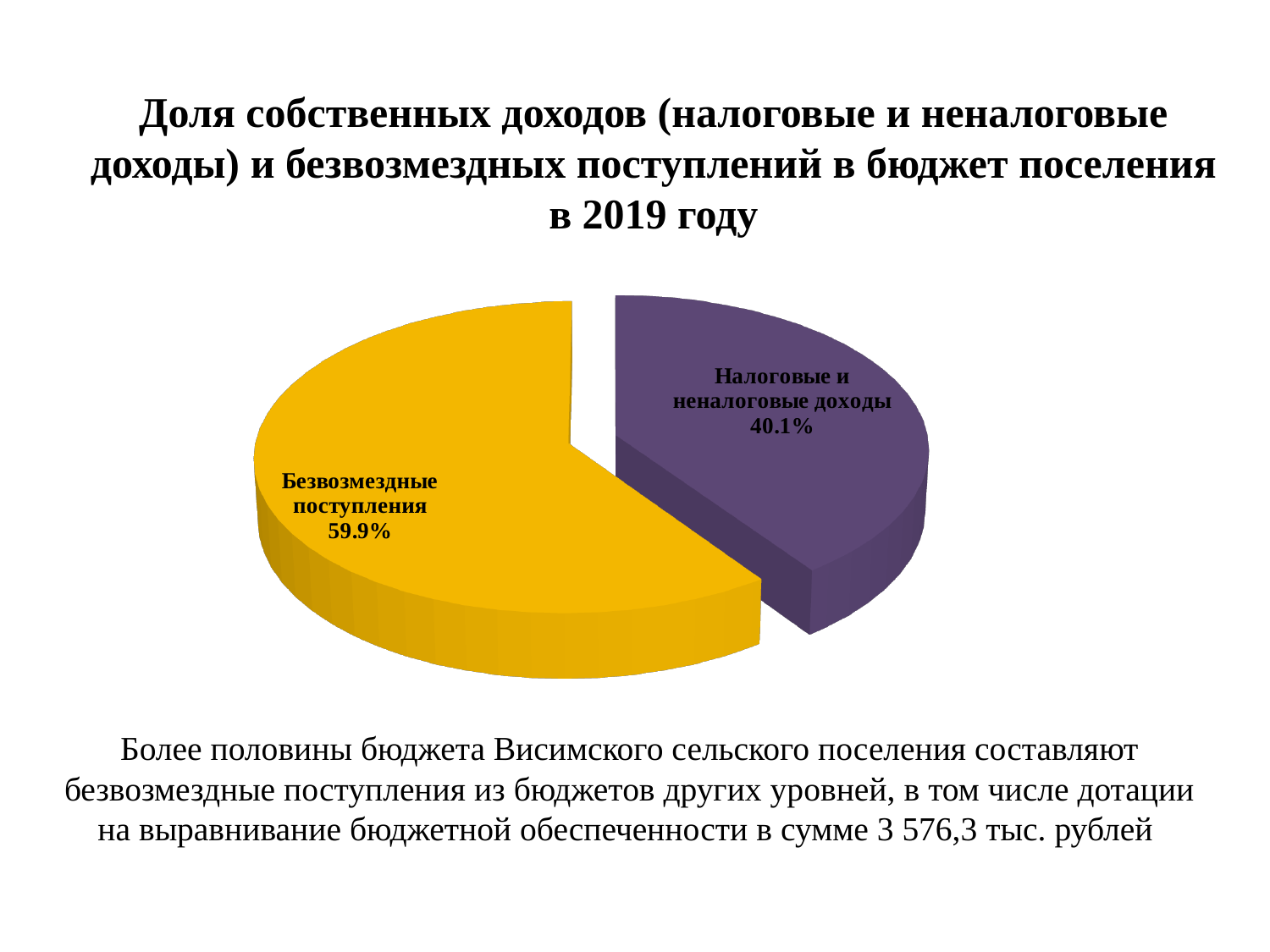
Which slice of the pie is the smallest? Налоговые и неналоговые доходы What is the difference in percentage points between "Безвозмездные поступления" and "Налоговые и неналоговые доходы"? 19.8 Is the share for "Налоговые и неналоговые доходы" greater or less than 50%? less Which slice of the pie is the largest? Безвозмездные поступления What kind of chart is shown on the slide? Pie chart What share of the pie does "Налоговые и неналоговые доходы" have? 40.1% What share of the pie does "Безвозмездные поступления" have? 59.9% What colour is the slice for "Безвозмездные поступления"? Yellow How many slices does the pie chart have? 2 What colour is the slice for "Налоговые и неналоговые доходы"? Purple Which is larger: "Безвозмездные поступления" or "Налоговые и неналоговые доходы"? Безвозмездные поступления